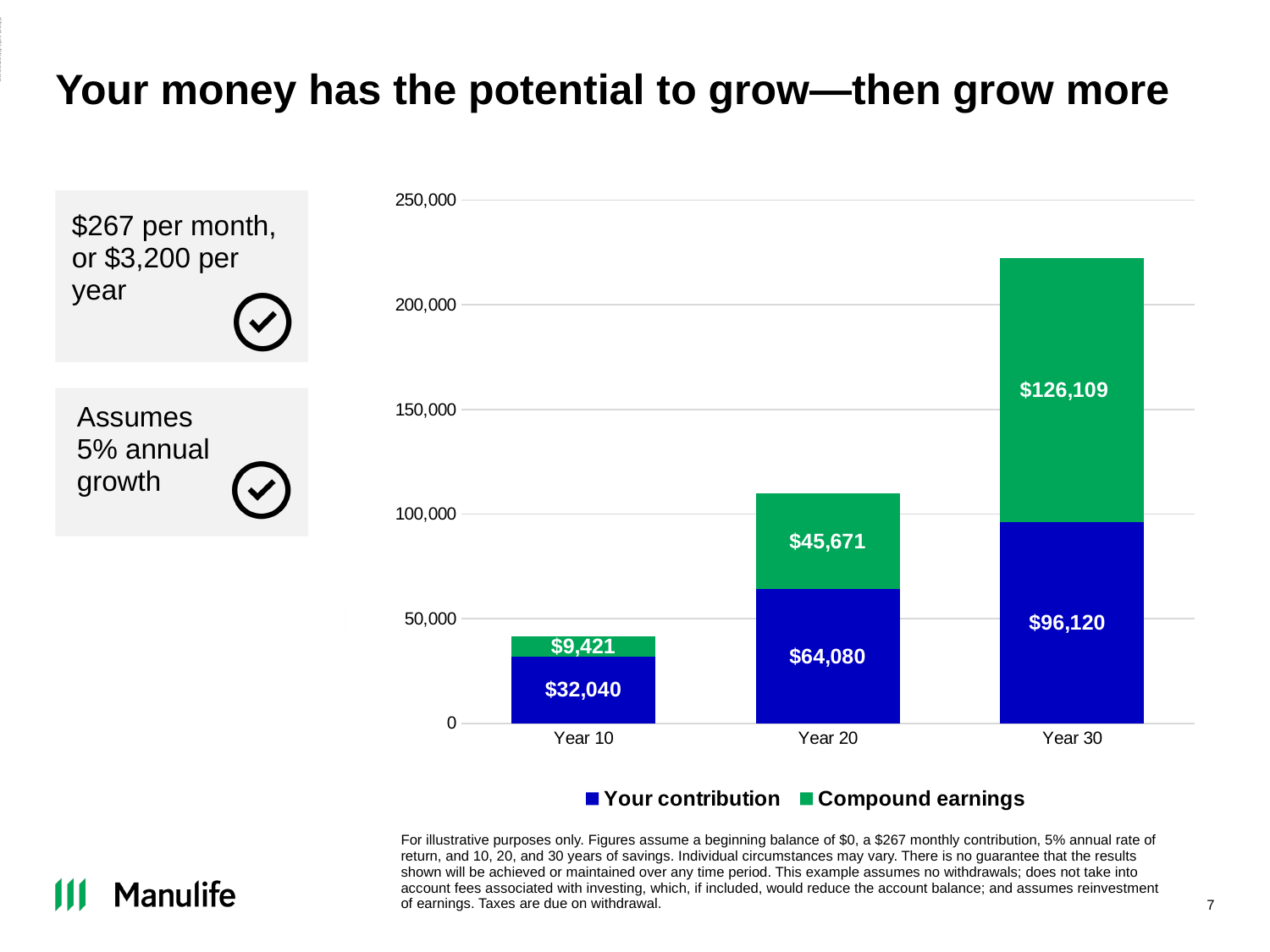
What is the total of the stacked bar for Year 20? $109,751 Which year has the highest Compound earnings? Year 30 For Year 30, which is larger: Your contribution or Compound earnings? Compound earnings Which year has the lowest Your contribution? Year 10 What is the difference between Your contribution for Year 30 and Year 10? $64,080 What is the value of Compound earnings for Year 30? $126,109 What is the value of Compound earnings for Year 10? $9,421 What is the value of Your contribution for Year 20? $64,080 How many series does the legend list? 2 How many years are shown on the x axis? 3 What kind of chart is shown on the slide? Stacked bar chart Is the total height of the Year 30 bar greater or less than 200,000? greater